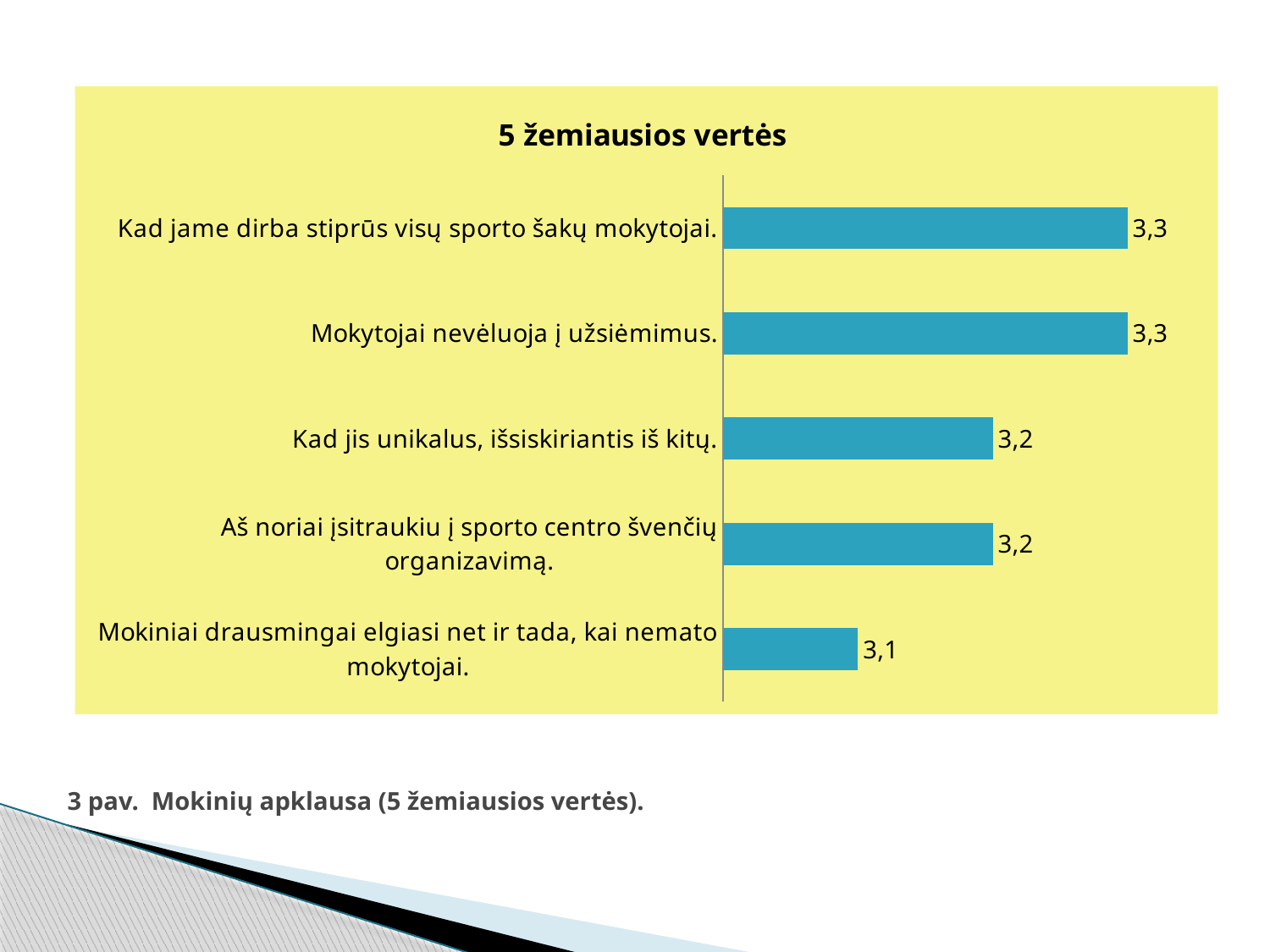
What is the difference between the value for "Kad jame dirba stiprūs visų sporto šakų mokytojai." and the value for "Mokiniai drausmingai elgiasi net ir tada, kai nemato mokytojai."? 0,2 What is the value for "Kad jis unikalus, išsiskiriantis iš kitų."? 3,2 Which category has the lowest value? Mokiniai drausmingai elgiasi net ir tada, kai nemato mokytojai. What is the value for "Mokytojai nevėluoja į užsiėmimus."? 3,3 What kind of chart is shown on the slide? Bar chart What is the difference between the value for "Mokytojai nevėluoja į užsiėmimus." and the value for "Kad jis unikalus, išsiskiriantis iš kitų."? 0,1 What is the value for "Mokiniai drausmingai elgiasi net ir tada, kai nemato mokytojai."? 3,1 What is the title of the chart? 5 žemiausios vertės What is the value for "Aš noriai įsitraukiu į sporto centro švenčių organizavimą."? 3,2 What is the caption below the chart? 3 pav. Mokinių apklausa (5 žemiausios vertės). Which is larger: the value for "Kad jis unikalus, išsiskiriantis iš kitų." or the value for "Mokiniai drausmingai elgiasi net ir tada, kai nemato mokytojai."? Kad jis unikalus, išsiskiriantis iš kitų. How many categories are shown in the chart? 5